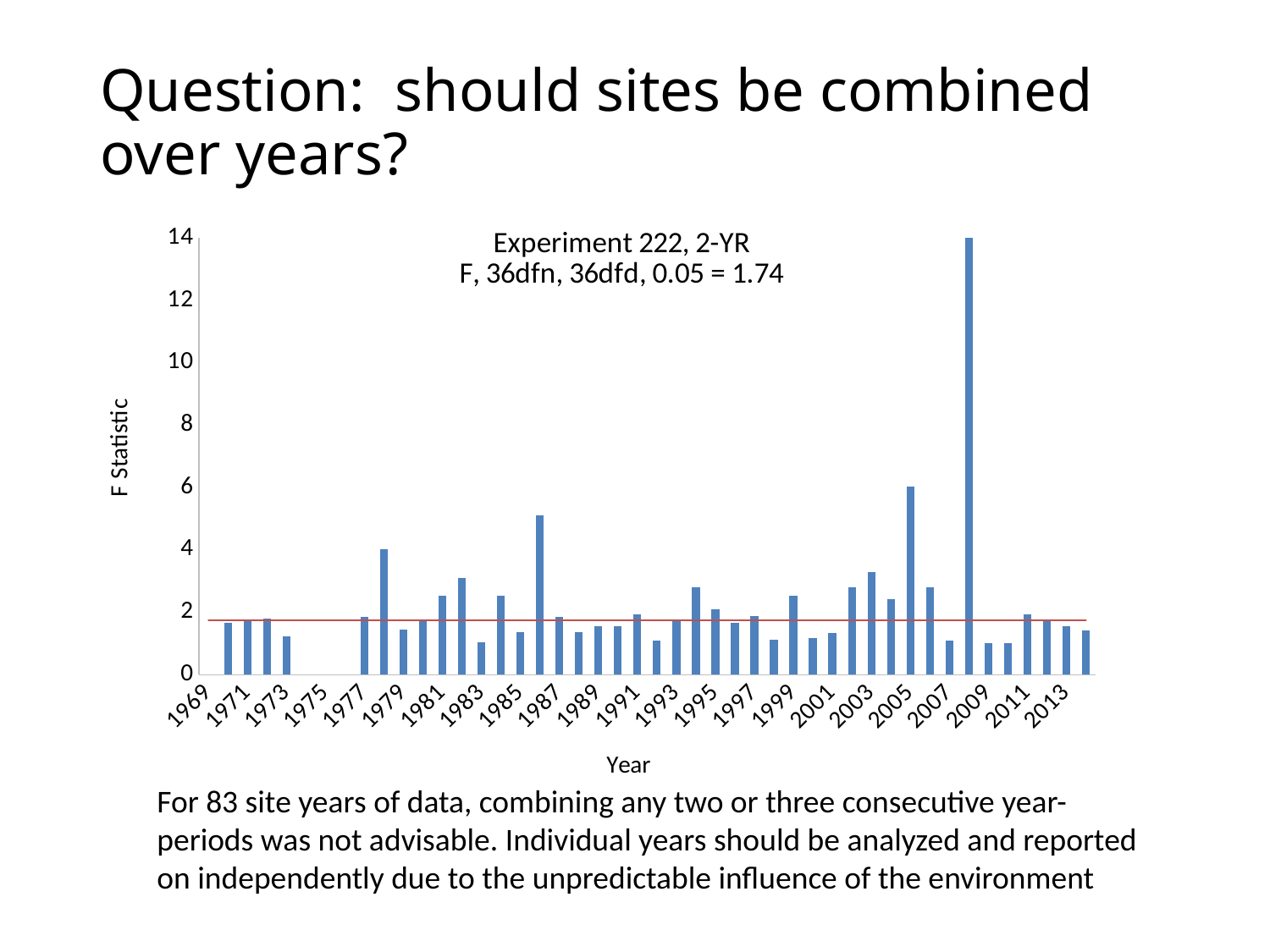
Which year has the larger F Statistic, 2005 or 1986? 2005 Is the F Statistic for 2005 greater or less than 4? greater Which year has the highest F Statistic? 2008 What kind of chart is shown on the slide? bar chart What is the label on the vertical axis of the chart? F Statistic What critical F value is stated in the chart title? 1.74 Is the F Statistic for 2008 greater or less than 12? greater Is the F Statistic for 1978 greater or less than 2? greater Which year has the larger F Statistic, 1978 or 1982? 1978